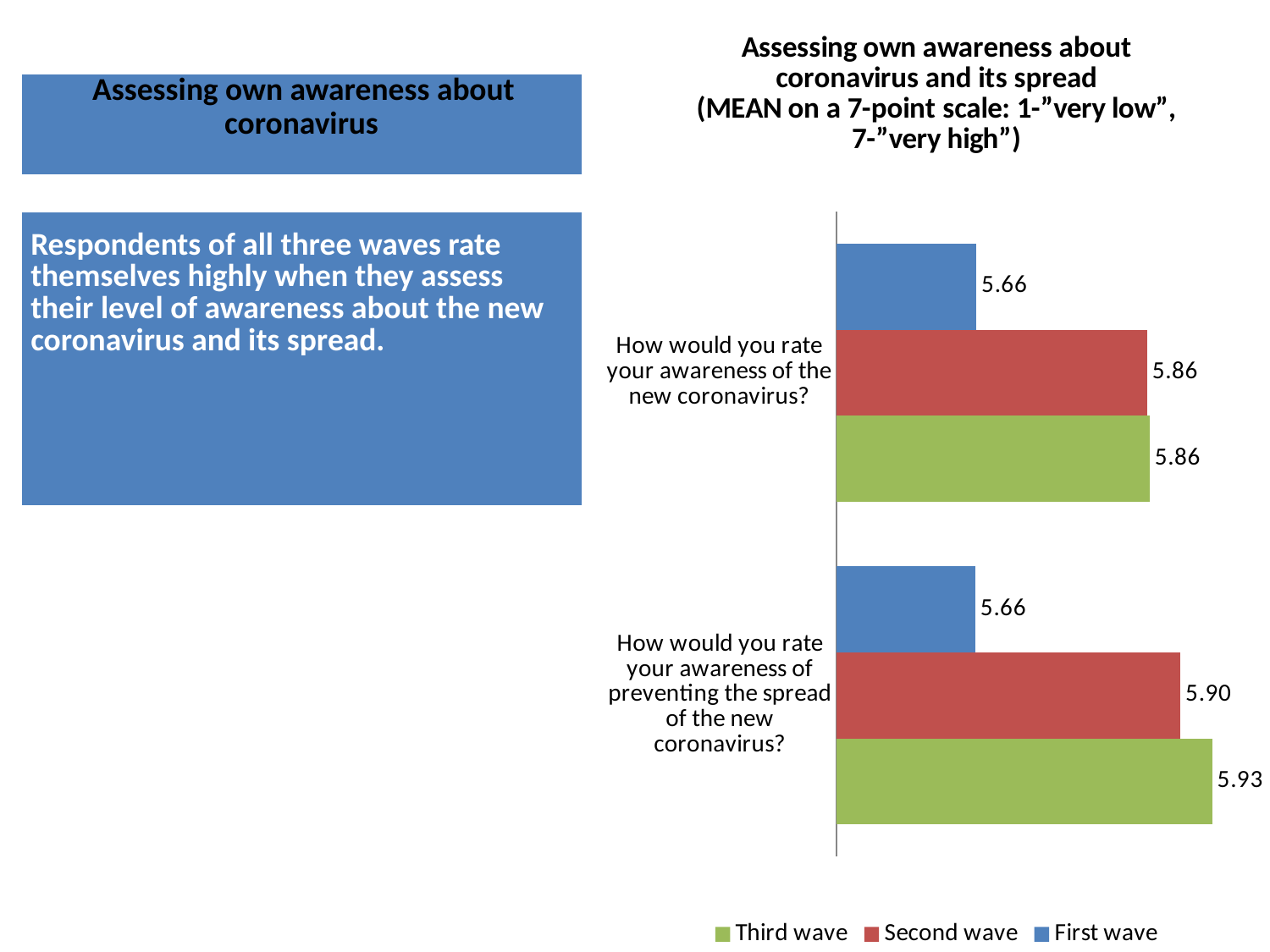
What is the Second wave value for "How would you rate your awareness of preventing the spread of the new coronavirus?"? 5.90 Which colour represents the Second wave in the chart legend? red What is the Second wave value for "How would you rate your awareness of the new coronavirus?"? 5.86 Which wave has the highest value for "How would you rate your awareness of preventing the spread of the new coronavirus?"? Third wave What is the First wave value for "How would you rate your awareness of the new coronavirus?"? 5.66 How many series does the chart legend list? 3 What kind of chart is shown on the slide? bar chart What is the difference between the Third wave and First wave values for "How would you rate your awareness of preventing the spread of the new coronavirus?"? 0.27 What is the Third wave value for "How would you rate your awareness of preventing the spread of the new coronavirus?"? 5.93 How many question categories are plotted on the chart? 2 Which is larger: the Second wave value for awareness of the new coronavirus or the Second wave value for awareness of preventing its spread? awareness of preventing the spread (5.90) Which wave has the lowest value for "How would you rate your awareness of the new coronavirus?"? First wave